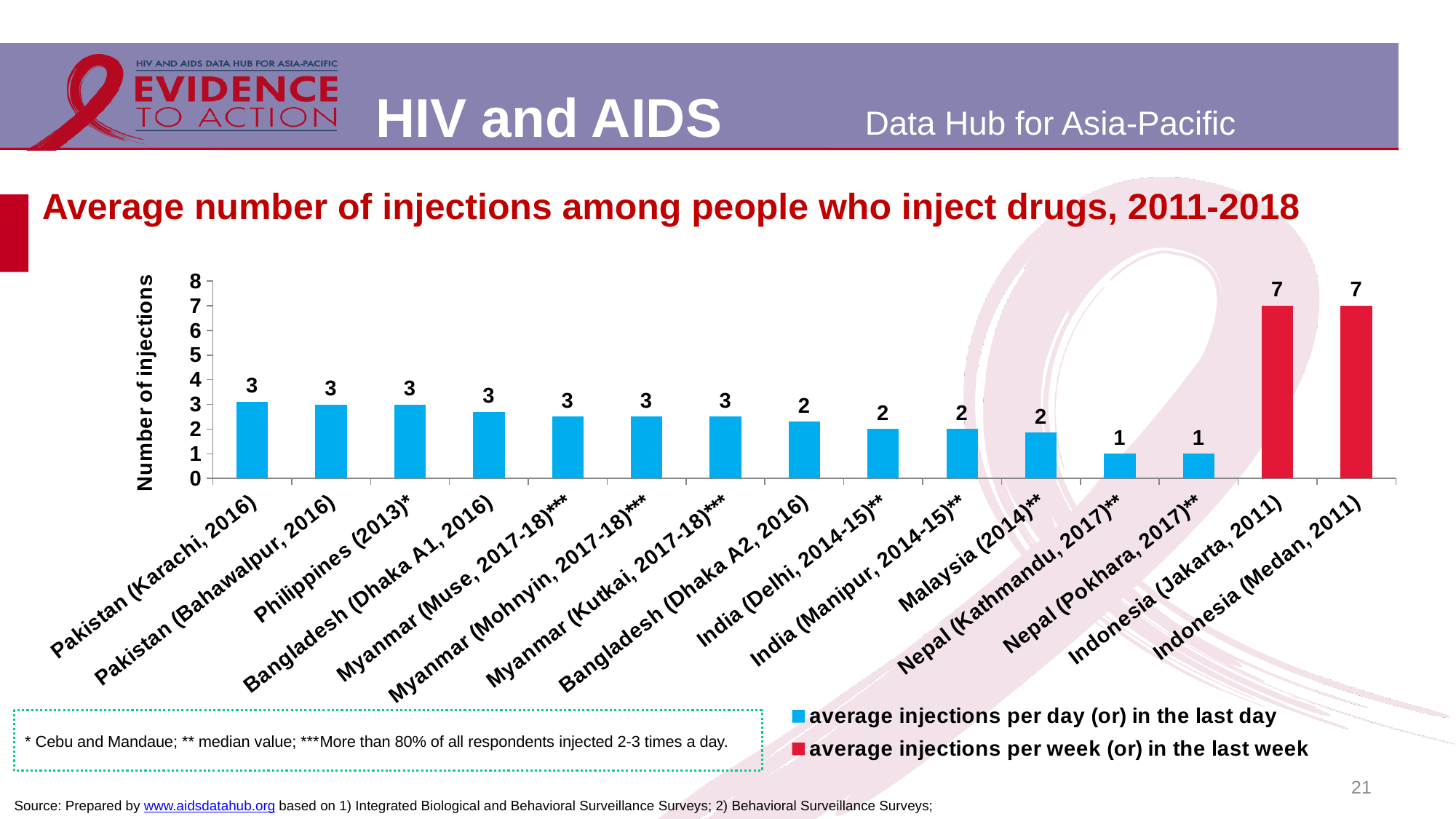
What is the value shown for Pakistan (Karachi, 2016)? 3 What is the value shown for India (Delhi, 2014-15)**? 2 What is the difference between the labelled values for Indonesia (Jakarta, 2011) and Nepal (Kathmandu, 2017)**? 6 What kind of chart is shown on the slide? bar chart Is the value for Indonesia (Medan, 2011) greater or less than 5? greater Which two categories have the highest values in the chart? Indonesia (Jakarta, 2011) and Indonesia (Medan, 2011) What is the value shown for Indonesia (Jakarta, 2011)? 7 How many series does the legend list? 2 Which has a larger value, Pakistan (Karachi, 2016) or Malaysia (2014)**? Pakistan (Karachi, 2016) What is the value shown for Nepal (Kathmandu, 2017)**? 1 Which two categories have the lowest values in the chart? Nepal (Kathmandu, 2017)** and Nepal (Pokhara, 2017)** How many categories are plotted on the x axis? 15